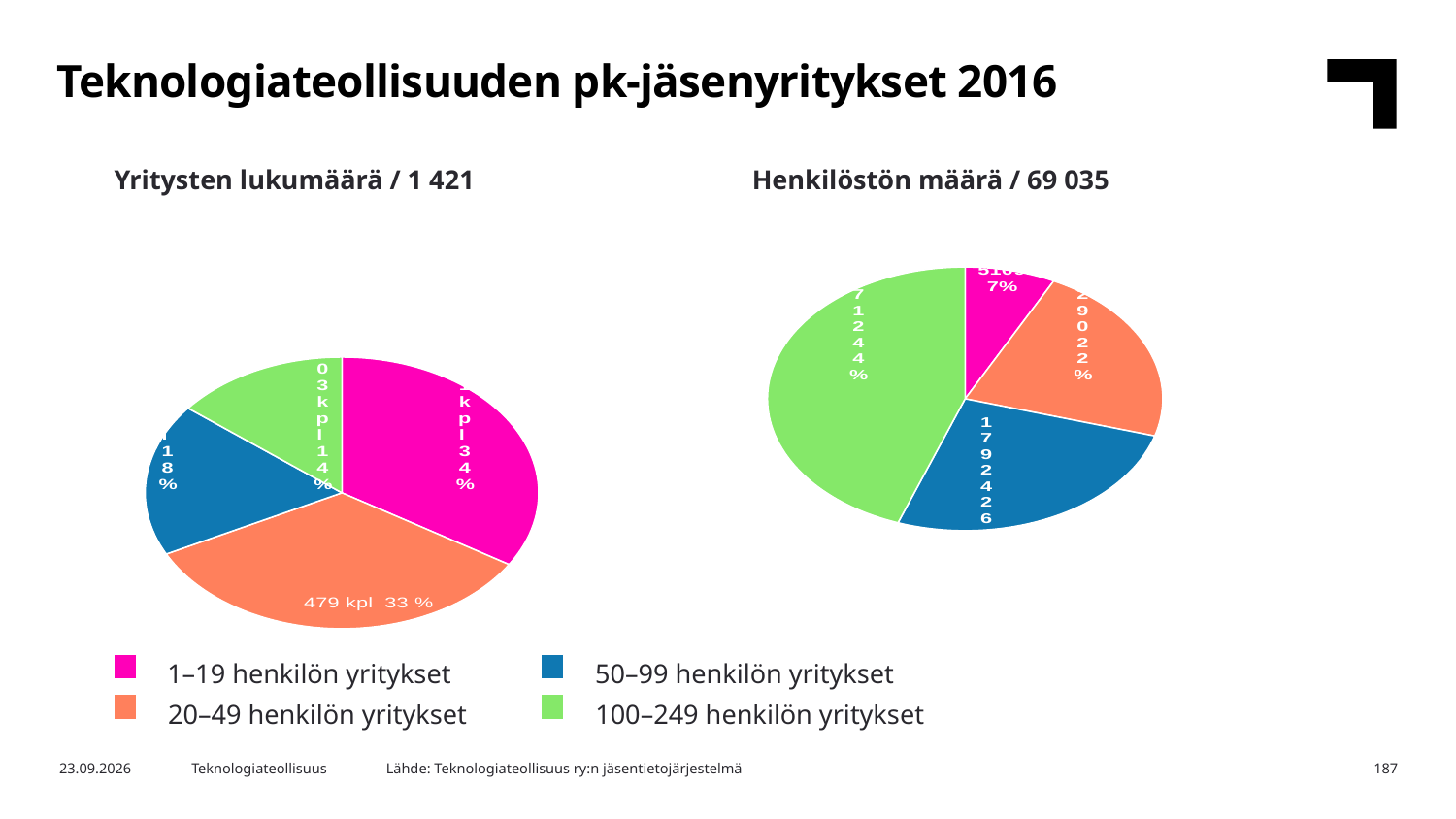
In the 'Yritysten lukumäärä / 1 421' chart, how many slices does the pie have? 4 In the 'Yritysten lukumäärä / 1 421' chart, which category has the smallest slice? 100–249 henkilön yritykset In the 'Yritysten lukumäärä / 1 421' chart, what share of the pie do 100–249 henkilön yritykset have? 14 % In the 'Yritysten lukumäärä / 1 421' chart, what share of the pie do 1–19 henkilön yritykset have? 34 % What kind of charts are shown on the slide? Pie charts In the 'Yritysten lukumäärä / 1 421' chart, what share of the pie do 50–99 henkilön yritykset have? 18 % In the 'Yritysten lukumäärä / 1 421' chart, what is the label shown for the 20–49 henkilön yritykset slice? 479 kpl 33 % In the 'Yritysten lukumäärä / 1 421' chart, how many percentage points larger is the 50–99 henkilön yritykset share than the 100–249 henkilön yritykset share? 4 percentage points In the 'Henkilöstön määrä / 69 035' chart, which category has the largest slice? 100–249 henkilön yritykset How many categories does the legend list? 4 In the 'Yritysten lukumäärä / 1 421' chart, which slice is larger: 50–99 henkilön yritykset or 100–249 henkilön yritykset? 50–99 henkilön yritykset